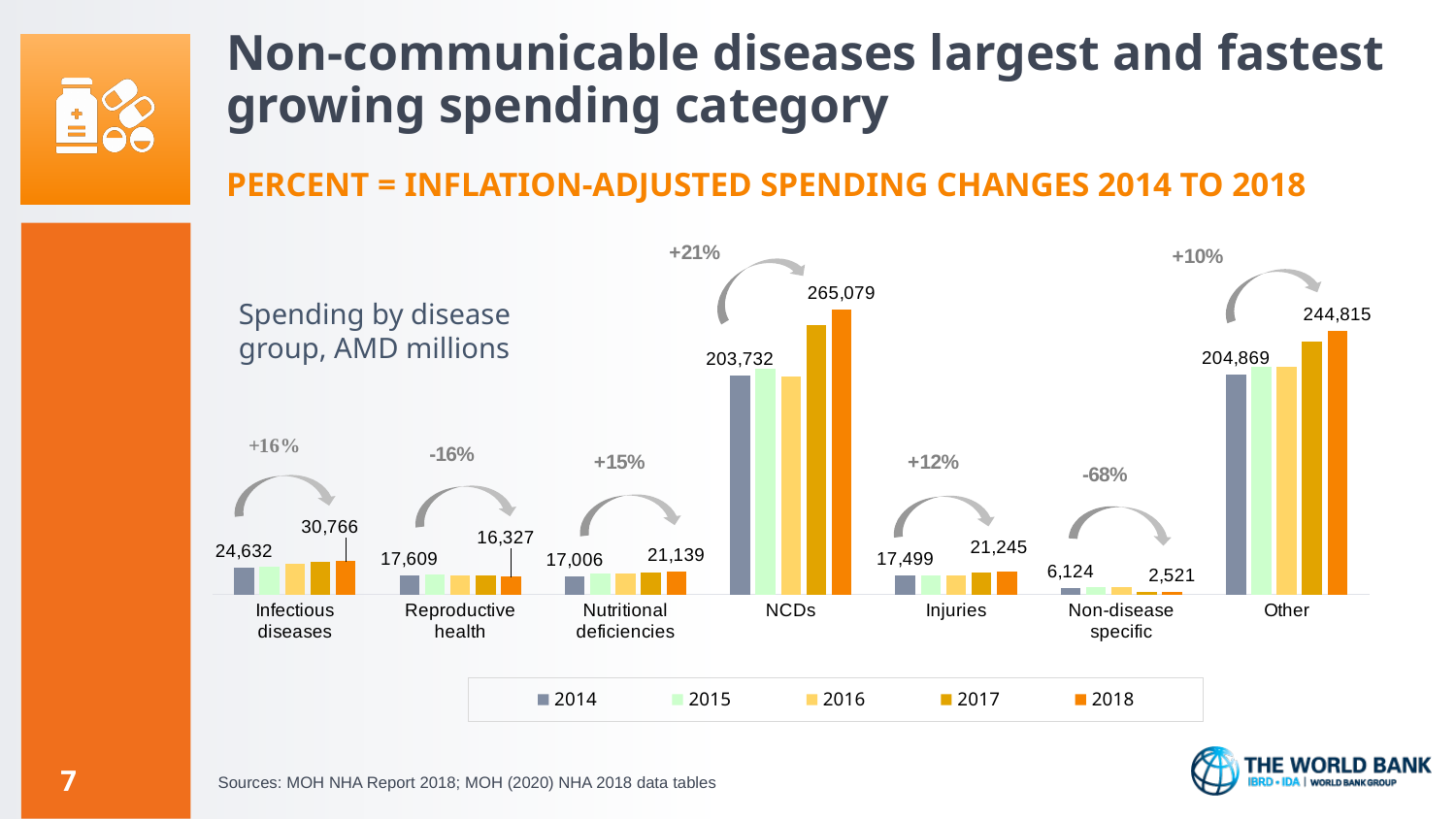
What is the 2018 spending value for NCDs? 265,079 What percentage change is annotated above the Non-disease specific bars? -68% What is the 2014 spending value for Other? 204,869 How many disease group categories are shown on the x axis? 7 What kind of chart is shown on the slide? Bar chart What is the 2014 spending value for Infectious diseases? 24,632 What is the 2018 spending value for Non-disease specific? 2,521 Which disease group has the lowest 2018 spending? Non-disease specific Which disease group has the highest 2018 spending? NCDs What is the difference between the 2018 and 2014 spending values for NCDs? 61,347 Which is larger: the 2018 spending for Reproductive health or the 2018 spending for Injuries? Injuries How many series does the legend list? 5